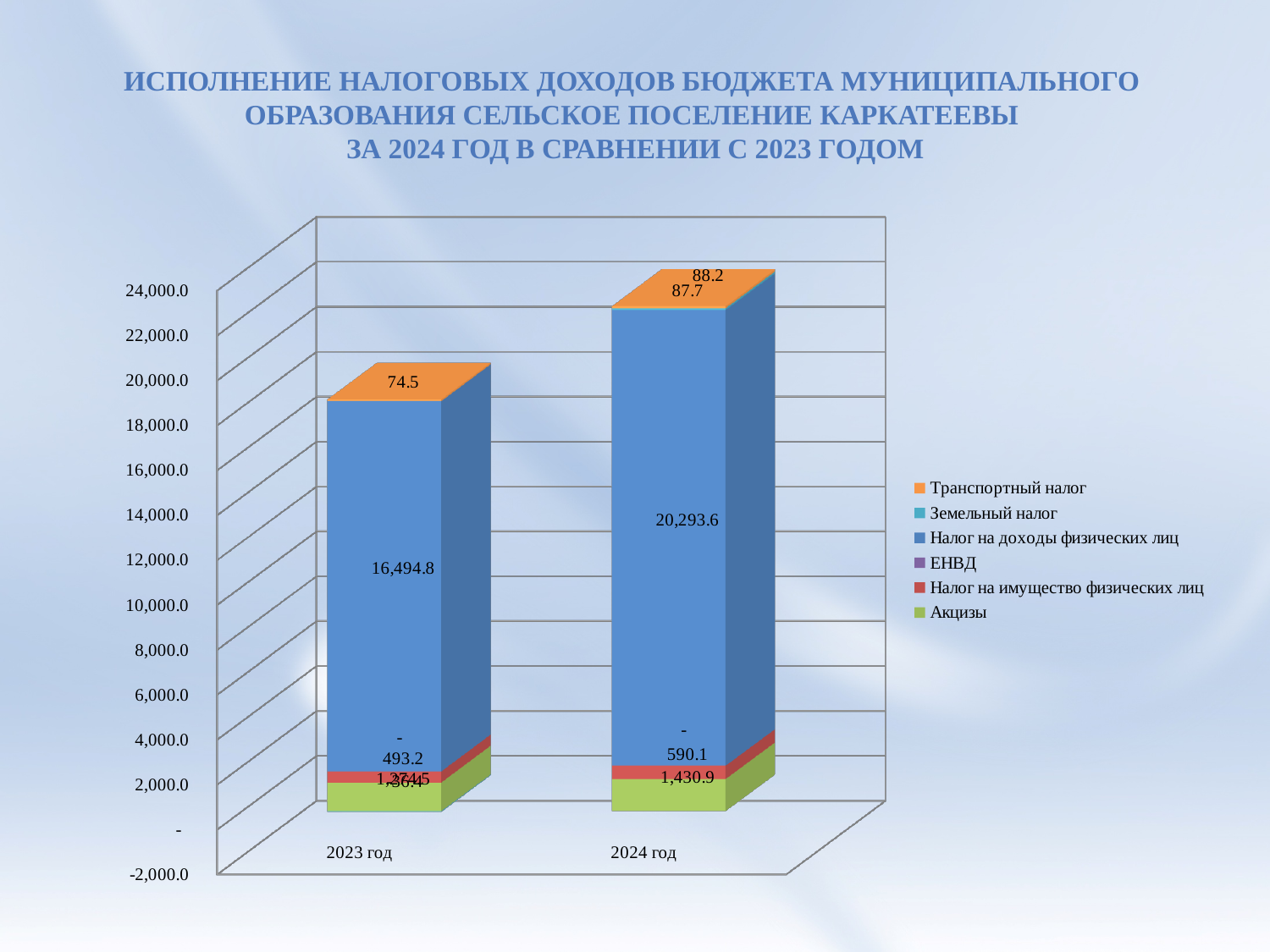
How many series does the legend list? 6 How many categories (years) are shown on the x axis? 2 What kind of chart is shown on the slide? Stacked bar chart Does the total height of the stacked bars rise or fall from 2023 год to 2024 год? Rise What is the value of Транспортный налог for 2023 год? 74.5 What is the value of Транспортный налог for 2024 год? 88.2 What is the value of Акцизы for 2024 год? 1,430.9 By how much did Налог на доходы физических лиц increase from 2023 год to 2024 год? 3,798.8 What is the value of Налог на доходы физических лиц for 2024 год? 20,293.6 What is the value of Налог на имущество физических лиц for 2024 год? 590.1 Which year has the larger value for Налог на имущество физических лиц, 2023 год or 2024 год? 2024 год What is the value of Налог на доходы физических лиц for 2023 год? 16,494.8